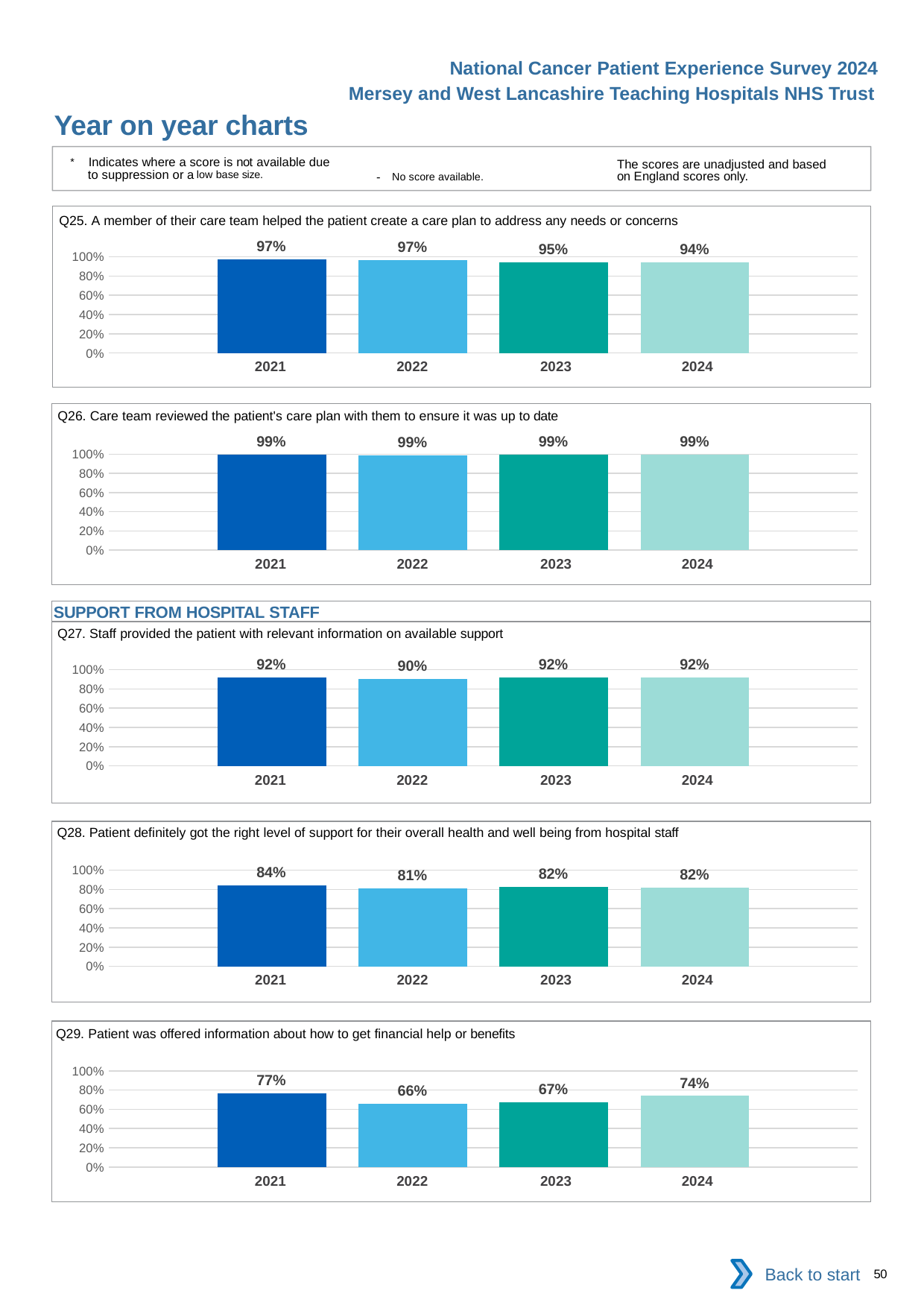
In the Q25 chart, what is the value for 2024? 94% In the Q27 chart, what is the difference between the 2021 and 2022 values? 2% In the Q29 chart, what is the difference between the 2021 and 2022 values? 11% In the Q29 chart, what is the value for 2023? 67% In the Q28 chart, which year has the highest value? 2021 In the Q27 chart, what is the value for 2022? 90% In the Q26 chart, how many years are plotted? 4 In the Q29 chart, which year has the lowest value? 2022 In the Q25 chart, which year has the lowest value? 2024 In the Q26 chart, what is the value for 2021? 99% In the Q28 chart, is the value for 2022 larger or smaller than the value for 2021? smaller What kind of chart is the Q29 chart? bar chart